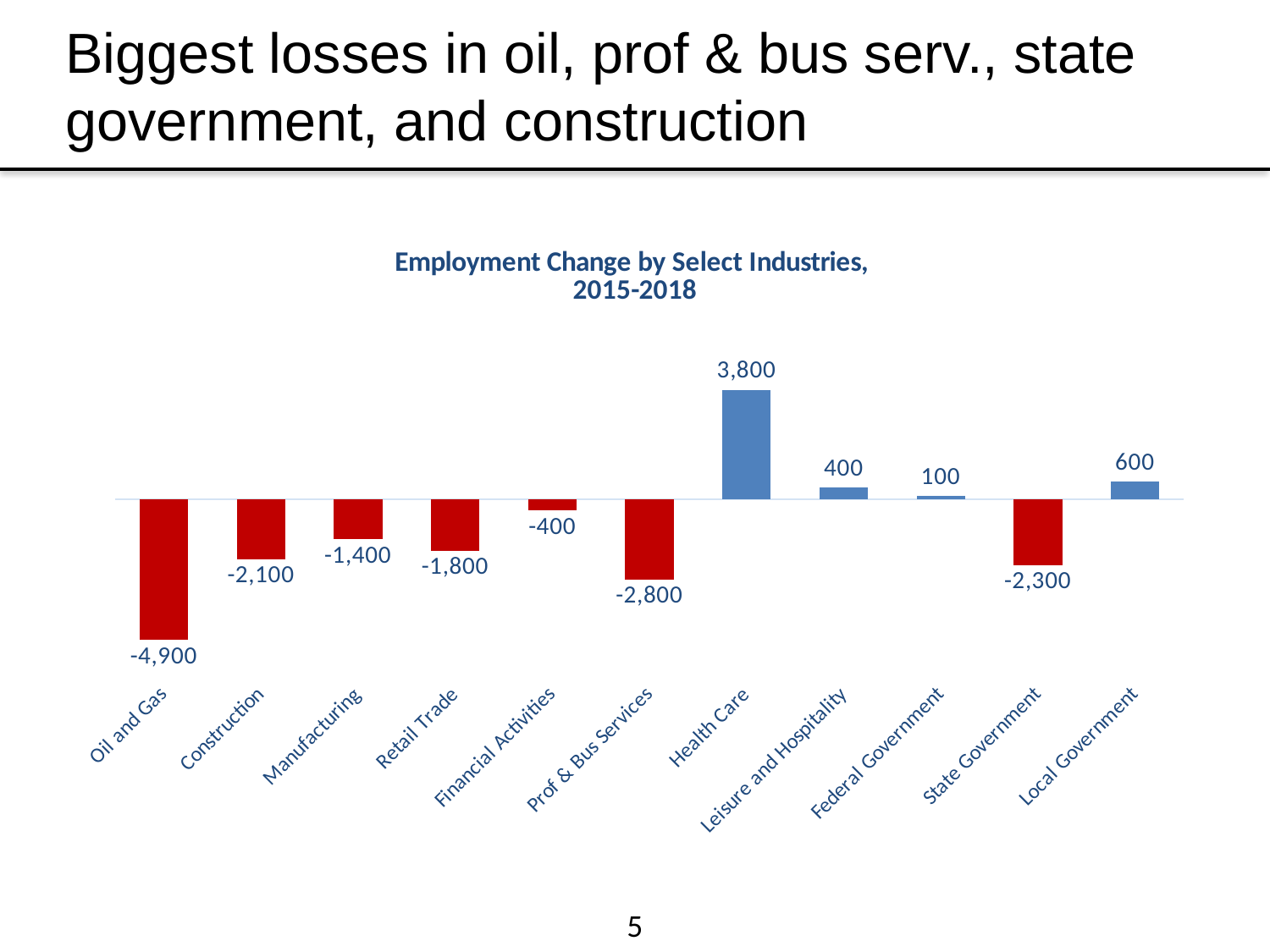
What is the employment change for State Government? -2,300 What is the employment change for Oil and Gas? -4,900 What is the employment change for Health Care? 3,800 What is the difference between the employment change for Construction and Retail Trade? 300 What is the title of the chart? Employment Change by Select Industries, 2015-2018 What is the employment change for Federal Government? 100 What kind of chart is shown on the slide? Bar chart How many industries are shown in the chart? 11 What is the difference between the employment change for Health Care and Local Government? 3,200 Which industry has the highest employment change? Health Care Which has a larger employment change, Leisure and Hospitality or Local Government? Local Government Which industry has the lowest employment change? Oil and Gas